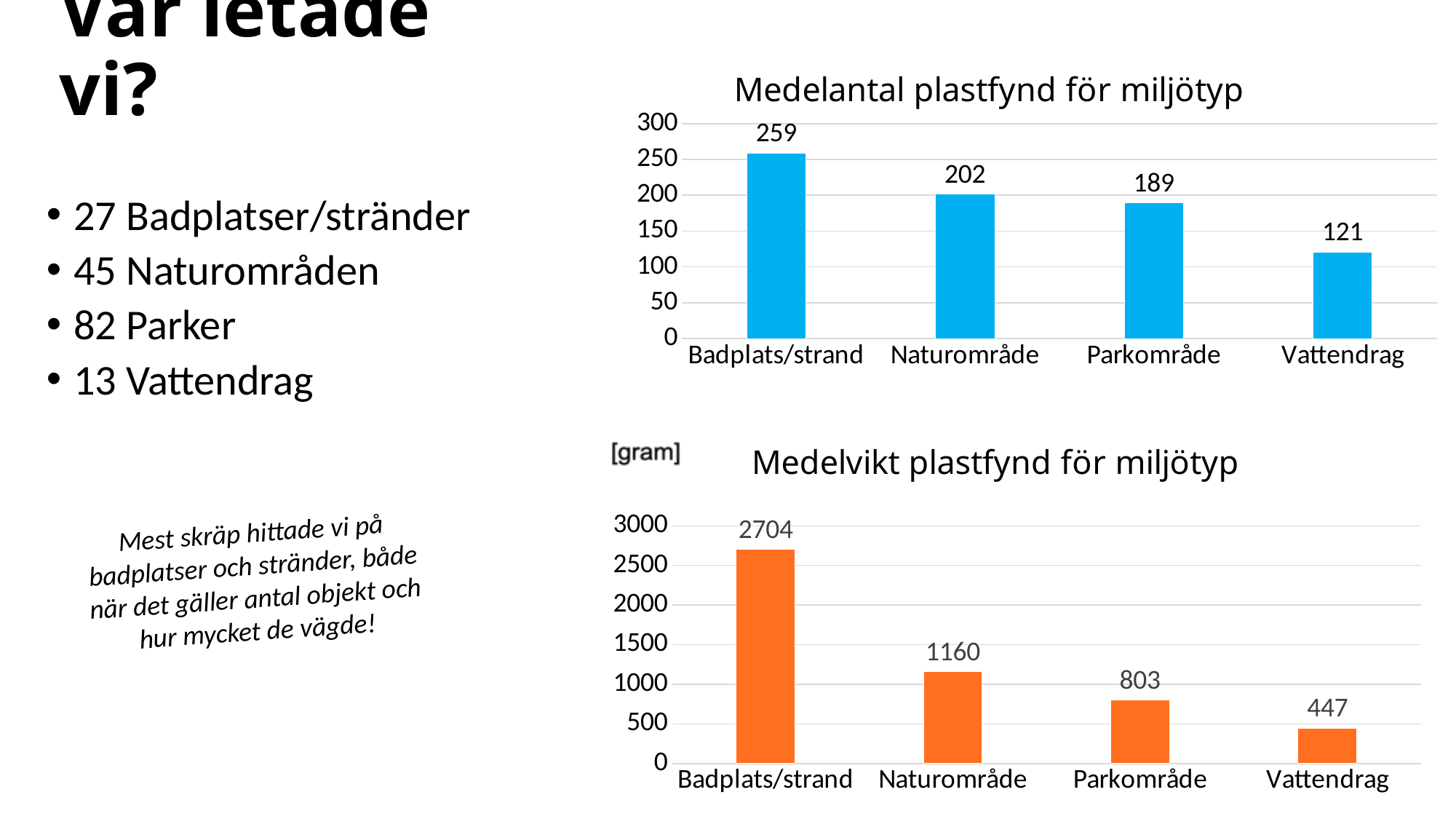
What unit is indicated above the chart 'Medelvikt plastfynd för miljötyp'? gram In the chart 'Medelvikt plastfynd för miljötyp', what is the difference between Naturområde and Vattendrag? 713 In the chart 'Medelantal plastfynd för miljötyp', what is the value for Naturområde? 202 In the chart 'Medelantal plastfynd för miljötyp', do the values rise or fall from left to right? fall In the chart 'Medelvikt plastfynd för miljötyp', which is larger, Naturområde or Parkområde? Naturområde In the chart 'Medelvikt plastfynd för miljötyp', is the value for Badplats/strand greater or less than 2500? greater In the chart 'Medelvikt plastfynd för miljötyp', which category has the highest value? Badplats/strand In the chart 'Medelvikt plastfynd för miljötyp', what is the value for Parkområde? 803 What kind of chart is 'Medelvikt plastfynd för miljötyp'? bar chart In the chart 'Medelantal plastfynd för miljötyp', which category has the lowest value? Vattendrag In the chart 'Medelantal plastfynd för miljötyp', how many categories are shown? 4 In the chart 'Medelantal plastfynd för miljötyp', what is the difference between Badplats/strand and Parkområde? 70